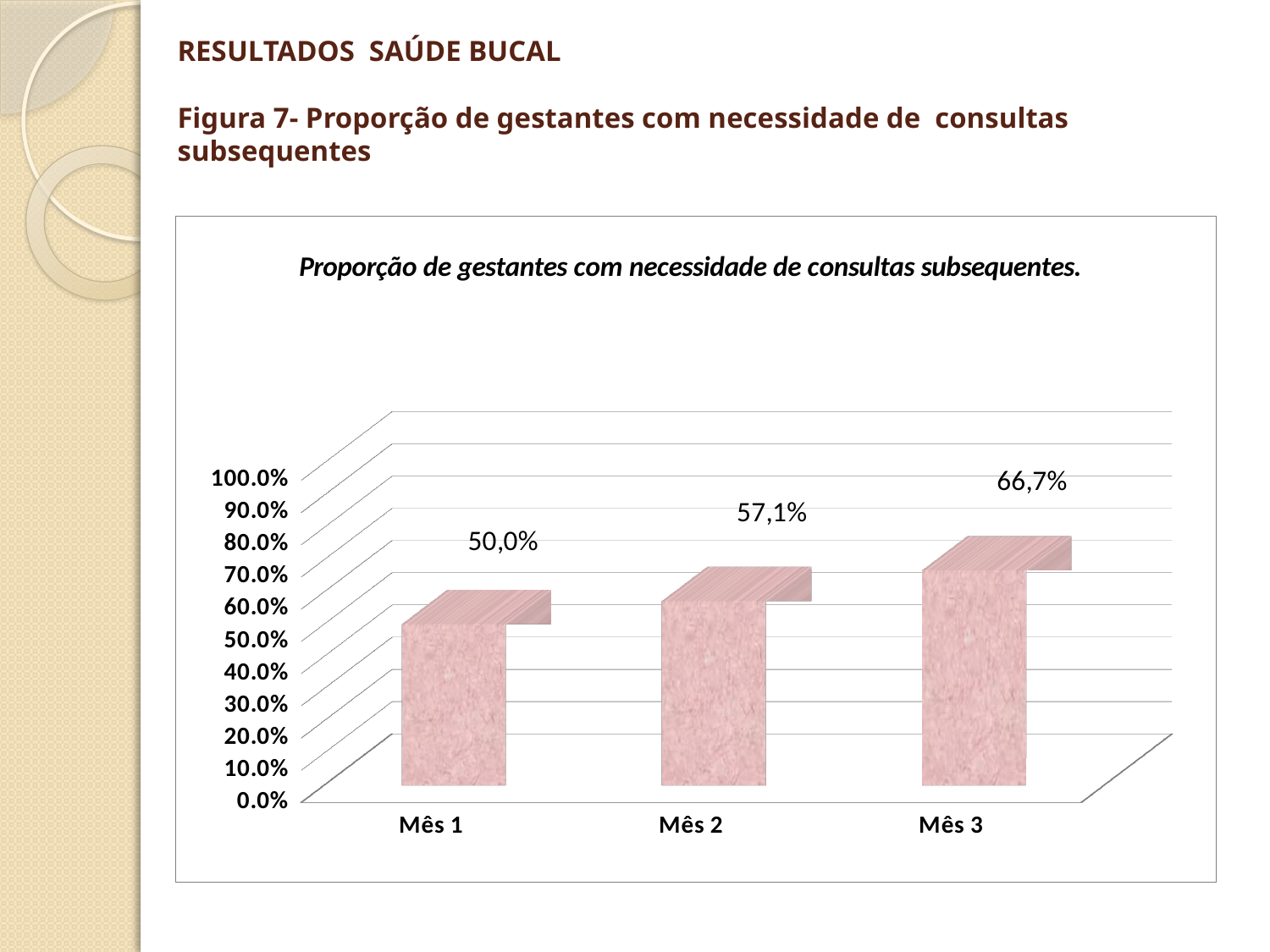
What is the title of the chart? Proporção de gestantes com necessidade de consultas subsequentes. Which is larger, the value for Mês 2 or the value for Mês 3? Mês 3 Which month has the lowest proportion? Mês 1 What is the difference between the values for Mês 3 and Mês 1? 16,7% What is the value for Mês 3? 66,7% What kind of chart is shown? Bar chart What is the value for Mês 2? 57,1% How many months are shown on the x axis? 3 What is the difference between the values for Mês 2 and Mês 1? 7,1% Do the values rise or fall from Mês 1 to Mês 3? Rise What is the value for Mês 1? 50,0% Which month has the highest proportion? Mês 3